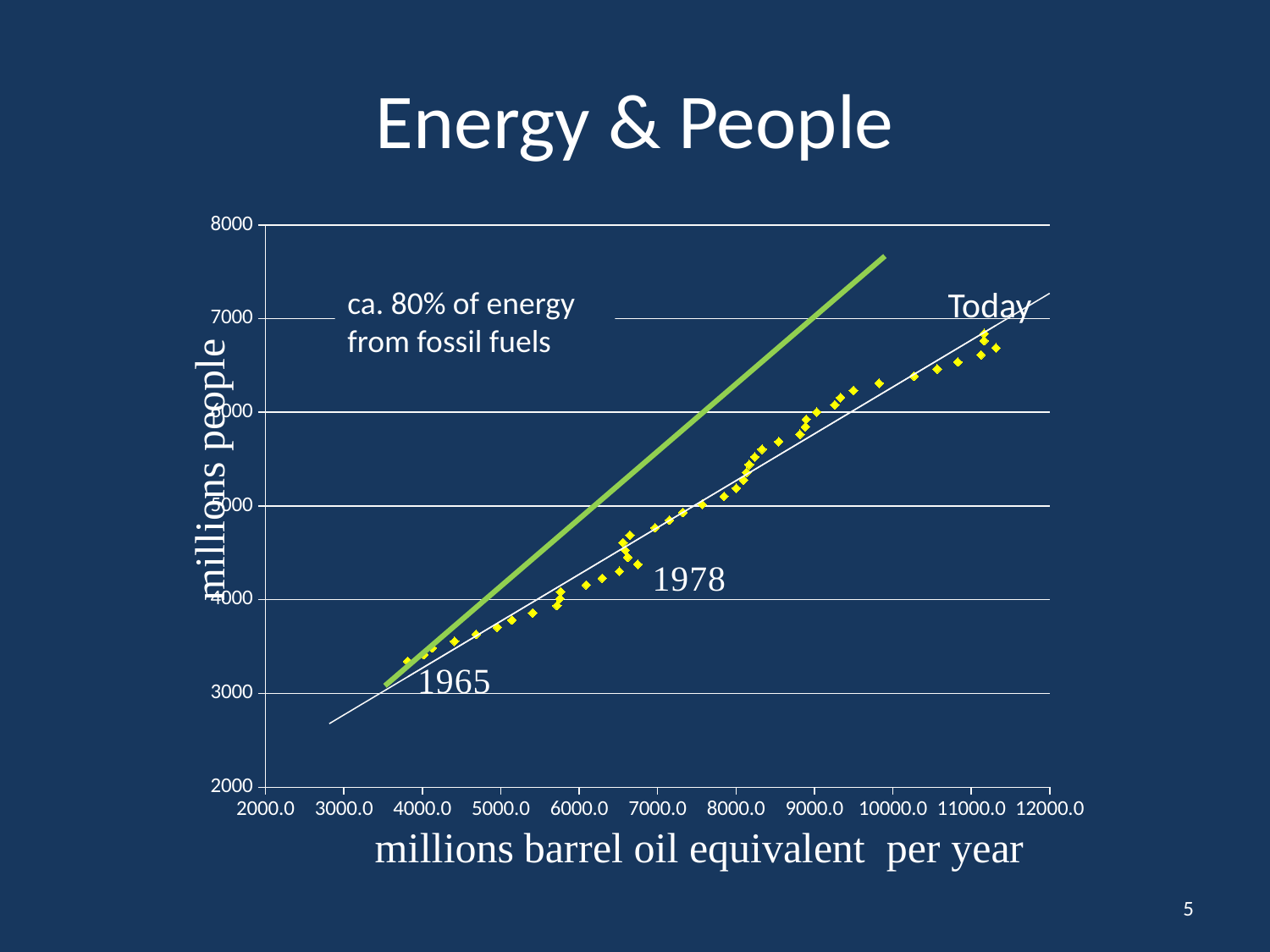
Which labelled point has the lowest population value: 1965, 1978 or Today? 1965 Is the population value for the point labelled 1965 greater or less than 4000 millions people? less What kind of chart is shown on the slide? Scatter chart Is the population value for the point labelled 1978 greater or less than 5000 millions people? less What is the label of the x axis? millions barrel oil equivalent per year Is the energy value for the point labelled 1965 greater or less than 5000.0 millions barrel oil equivalent per year? less Do the plotted points rise or fall as energy use increases along the x axis? Rise Which labelled point has the higher population value, 1965 or Today? Today What is the title of the chart? Energy & People What is the highest value shown on the y axis? 8000